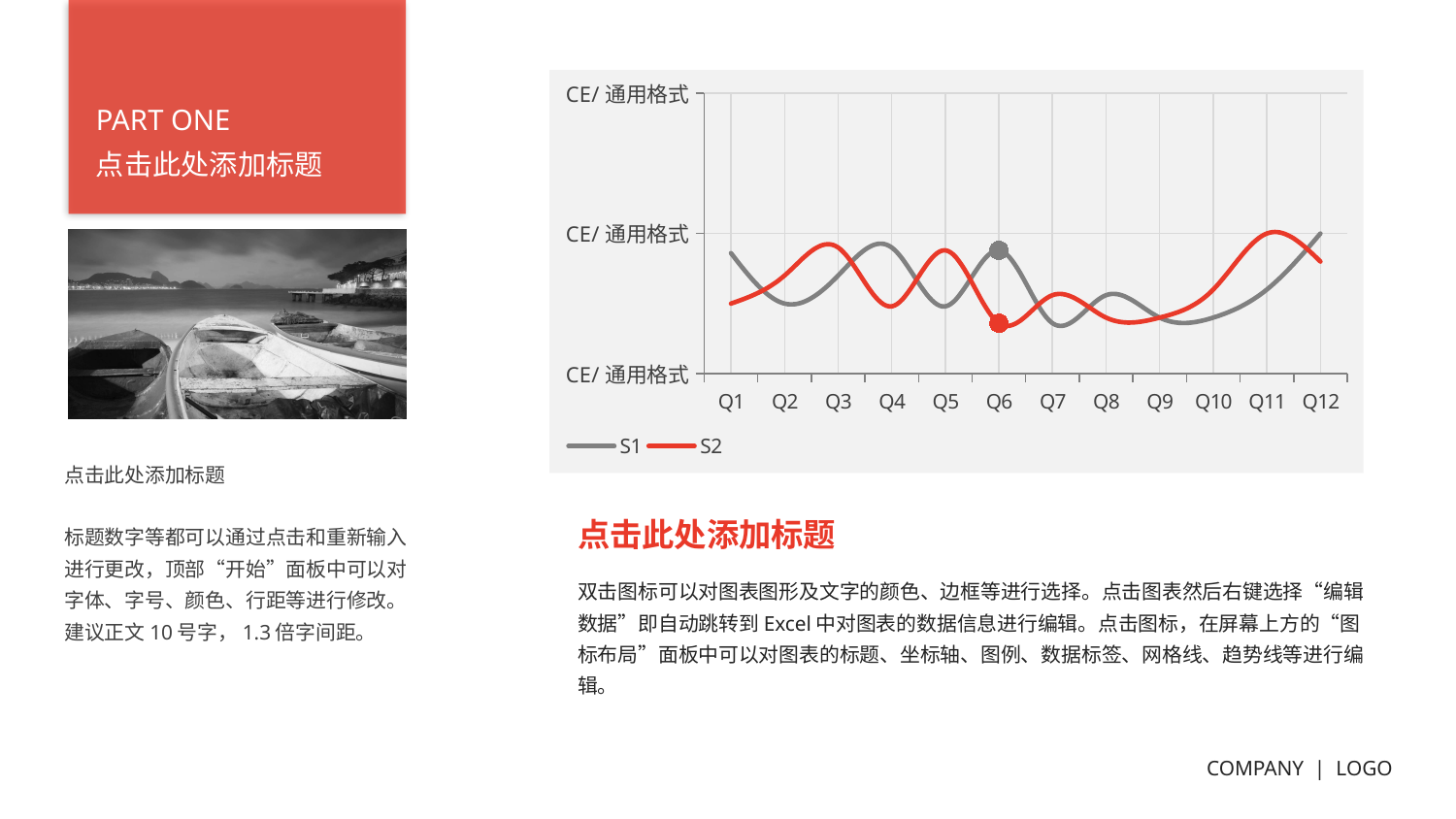
At Q11, which series has the higher value, S1 or S2? S2 How many series does the chart's legend list? 2 How many categories are shown on the x axis of the chart? 12 Which series is drawn in red in the chart? S2 At Q6, which series has the higher value, S1 or S2? S1 What are the names of the series listed in the chart's legend? S1 and S2 At which category does series S2 reach its highest value? Q11 At which category does series S1 reach its highest value? Q12 At Q1, which series has the higher value, S1 or S2? S1 From Q9 to Q12, does series S1 rise or fall? rise What kind of chart is shown on the slide? line chart